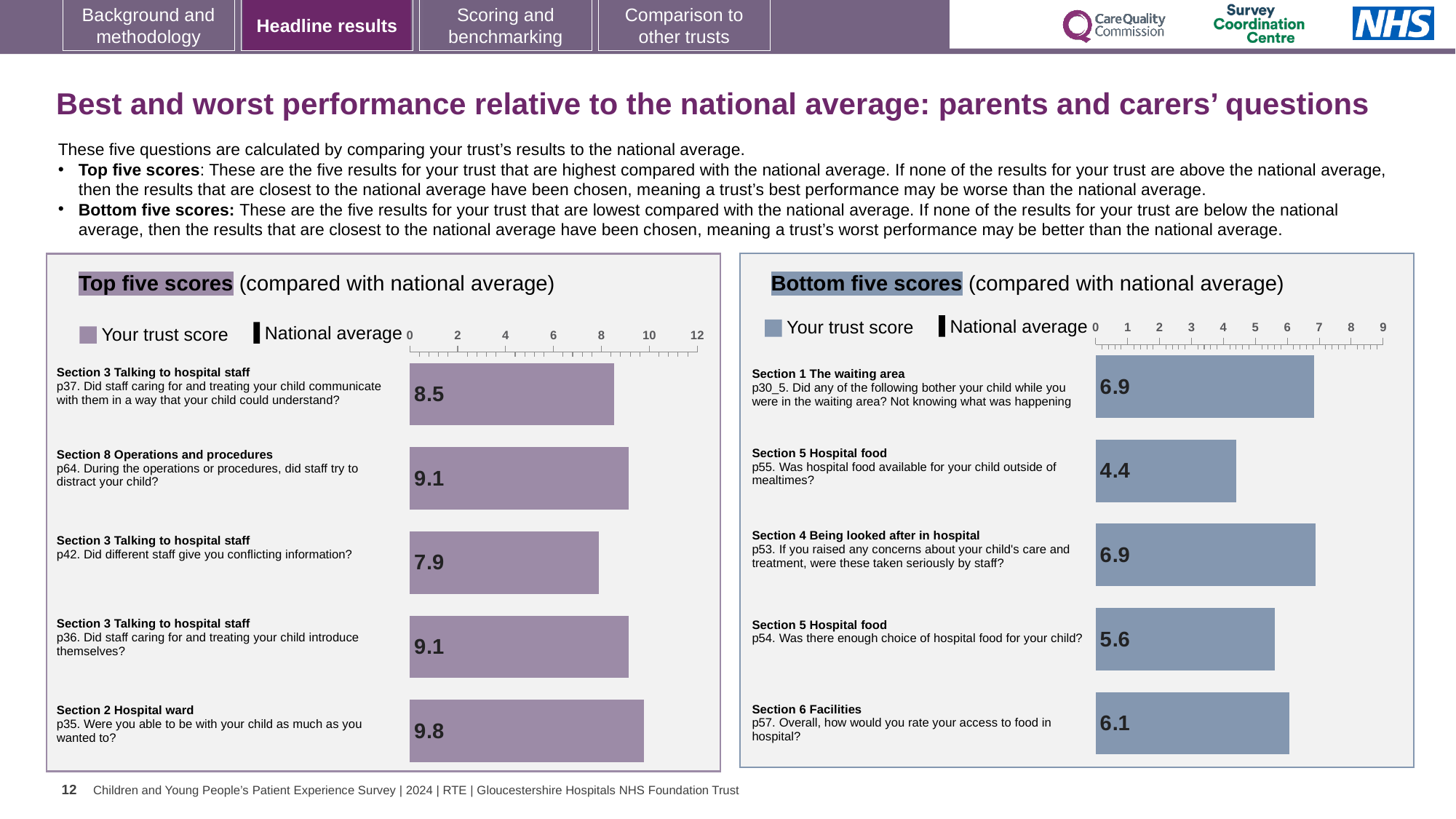
In the Top five scores chart, what is the difference between the trust scores for p35 and p42? 1.9 How many questions are plotted in the Bottom five scores chart? 5 In the Bottom five scores chart, which is larger: the trust score for p54 or for p57? p57 In the Top five scores chart, which question has the highest trust score? p35. Were you able to be with your child as much as you wanted to? In the Bottom five scores chart, what is the trust score for p57 (Overall, how would you rate your access to food in hospital?)? 6.1 In the Bottom five scores chart, what is the difference between the trust scores for p30_5 and p54? 1.3 In the Bottom five scores chart, what is the trust score for p55 (Was hospital food available for your child outside of mealtimes?)? 4.4 In the Bottom five scores chart, which question has the lowest trust score? p55. Was hospital food available for your child outside of mealtimes? What kind of chart is the Top five scores chart? Bar chart In the Top five scores chart, what is the trust score for p35 (Were you able to be with your child as much as you wanted to?)? 9.8 In the Top five scores chart, what is the trust score for p37 (Did staff caring for and treating your child communicate with them in a way that your child could understand?)? 8.5 In the Top five scores chart, which question has the lowest trust score? p42. Did different staff give you conflicting information?